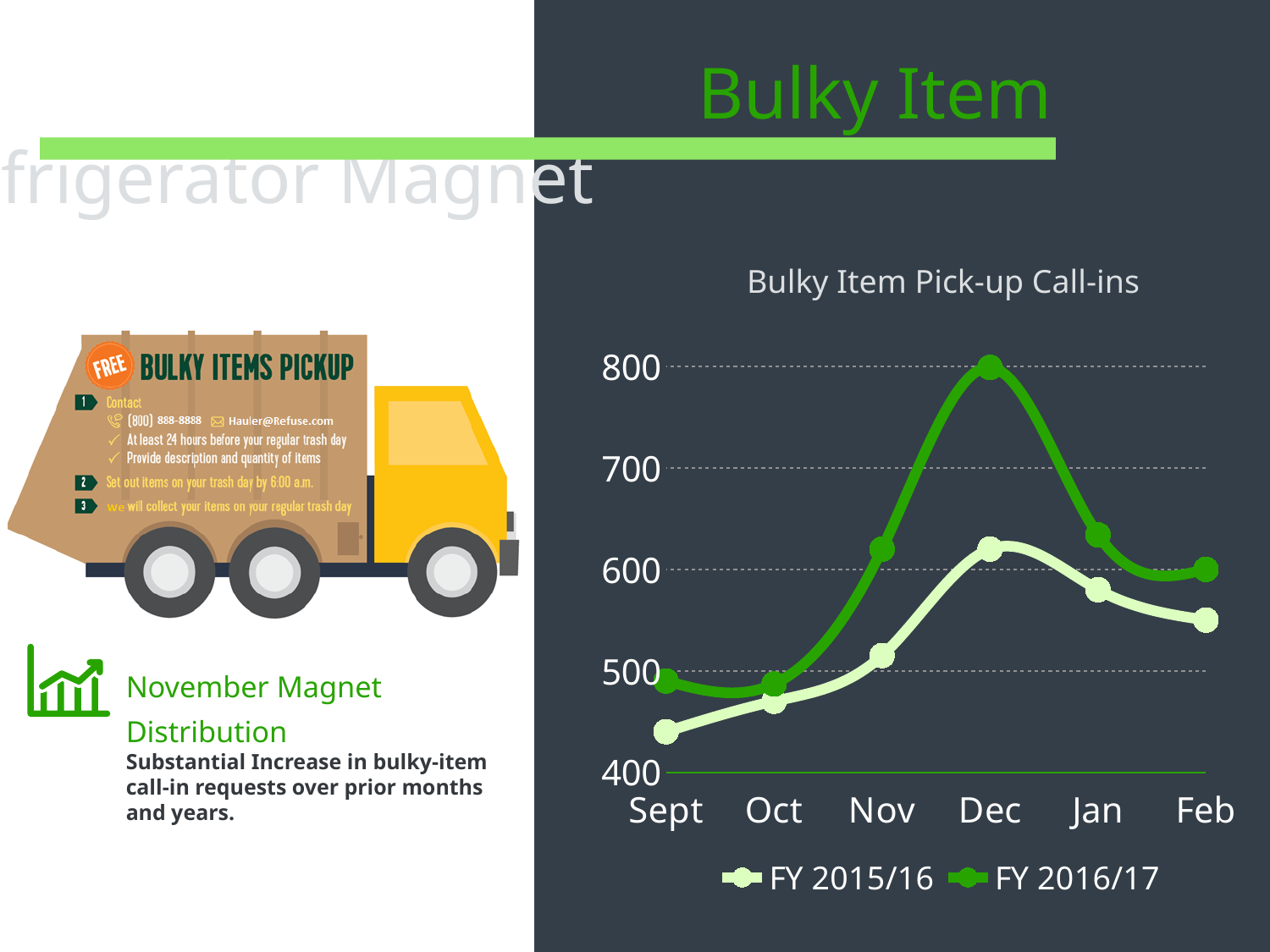
How many series does the chart's legend list? 2 In which month is the FY 2015/16 series at its lowest value? Sept Does the FY 2016/17 series rise or fall from Sept to Dec? rise In which month does the FY 2016/17 series reach its highest value? Dec How many months are shown on the x axis of the chart? 6 What is the title of the chart? Bulky Item Pick-up Call-ins In which month does the FY 2015/16 series reach its highest value? Dec In Dec, which series has the larger value, FY 2015/16 or FY 2016/17? FY 2016/17 What kind of chart is shown on the slide? line chart Is the value for FY 2015/16 in Sept greater or less than 500? less Is the value for FY 2016/17 in Nov greater or less than 600? greater